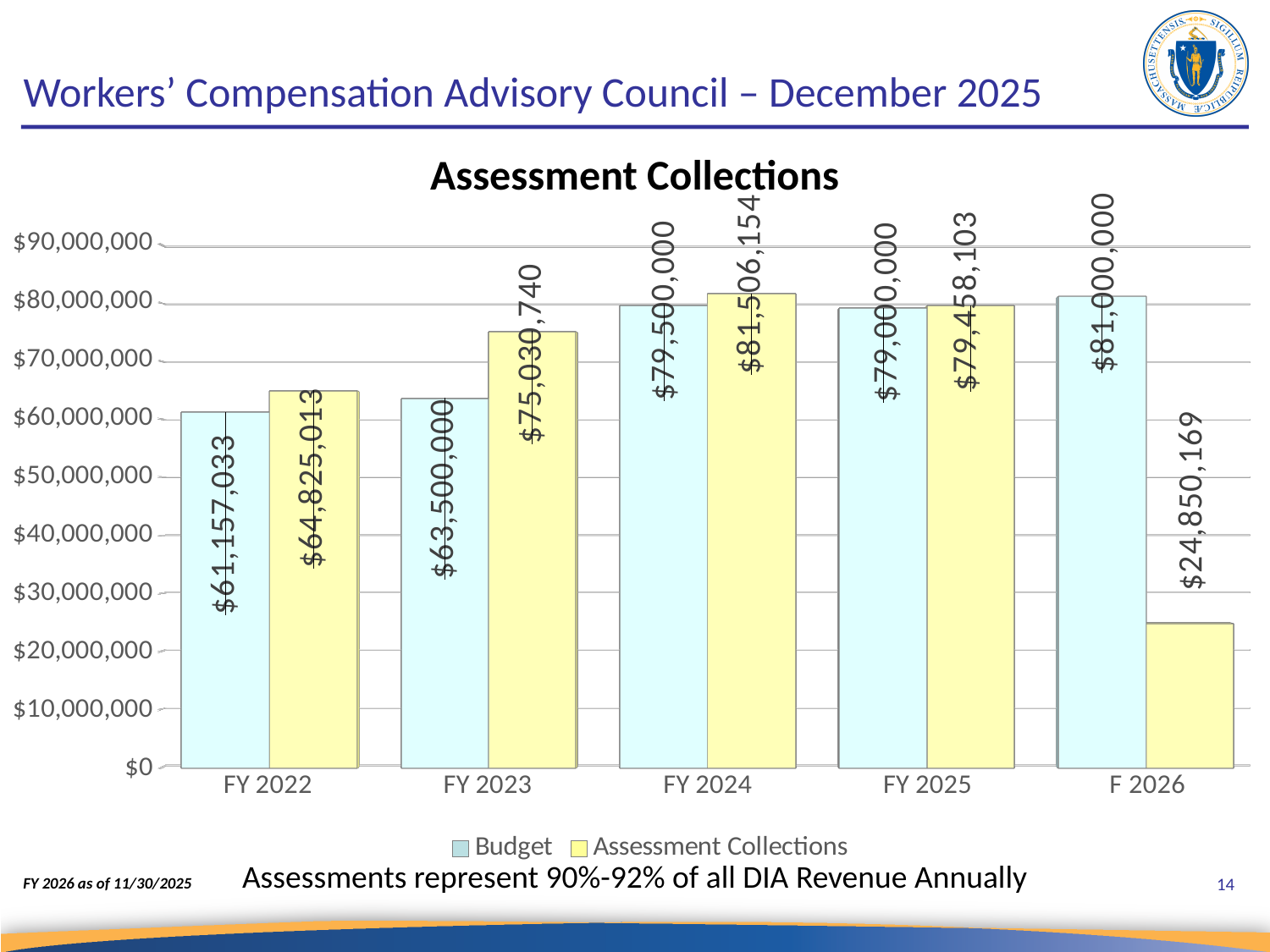
For FY 2023, which is larger: the Budget or the Assessment Collections? Assessment Collections What is the Assessment Collections value for FY 2023? $75,030,740 What is the Budget value for FY 2024? $79,500,000 Is the Assessment Collections value for F 2026 greater or less than $30,000,000? less What is the difference between Assessment Collections and Budget for FY 2022? $3,667,980 How many series does the legend list? 2 What kind of chart is shown on the slide? bar chart Which fiscal year has the lowest Budget value? FY 2022 What is the Assessment Collections value for F 2026? $24,850,169 How many fiscal years are shown on the x axis? 5 Which fiscal year has the highest Assessment Collections value? FY 2024 What is the Budget value for FY 2022? $61,157,033